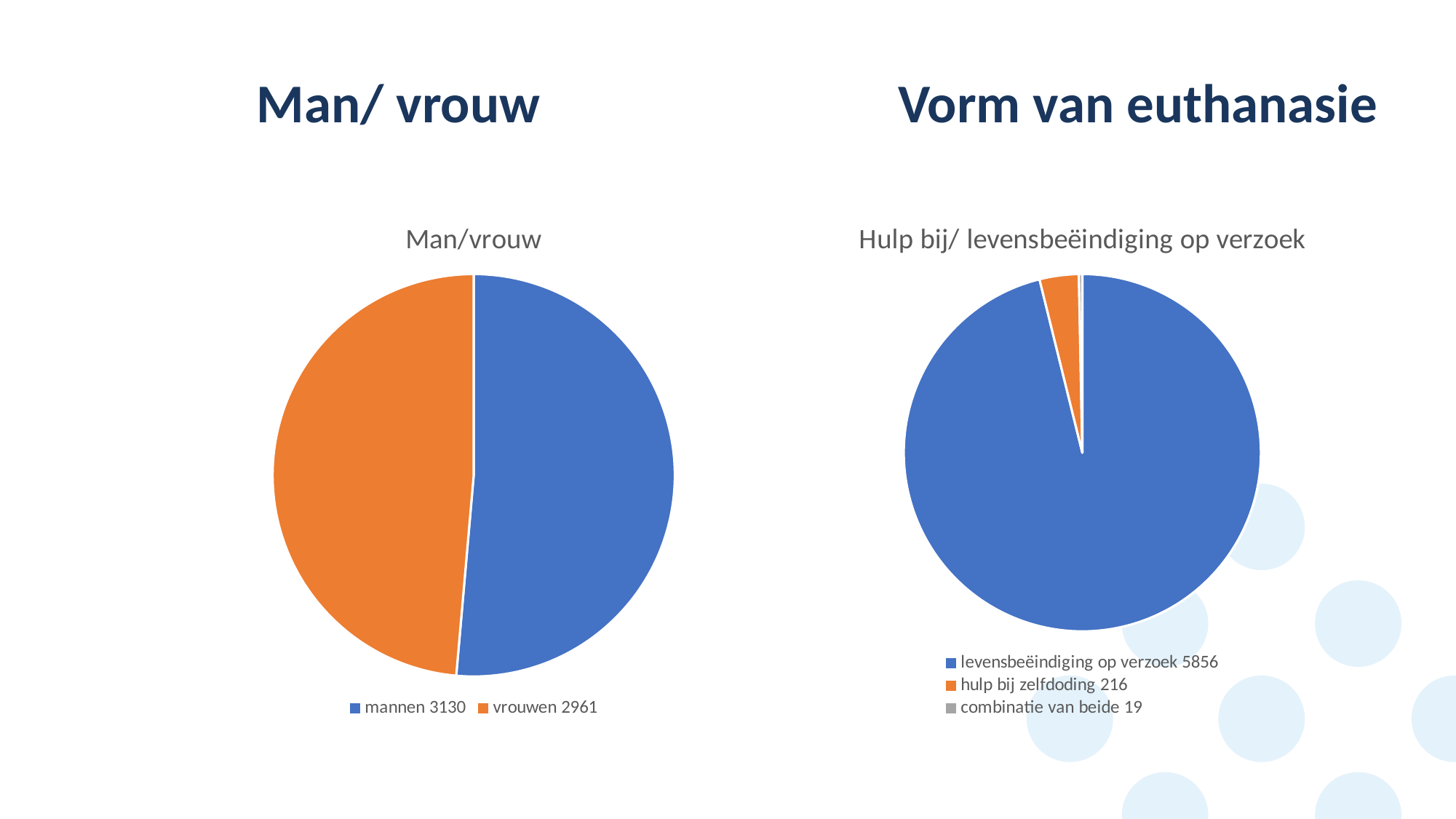
What kind of chart is the Man/vrouw chart? pie chart In the Man/vrouw chart, what is the total of the two categories? 6091 In the Man/vrouw chart, what is the difference between mannen and vrouwen? 169 In the Hulp bij/ levensbeëindiging op verzoek chart, which category is the smallest? combinatie van beide In the Man/vrouw chart, what is the value for vrouwen? 2961 In the Hulp bij/ levensbeëindiging op verzoek chart, what is the value for combinatie van beide? 19 In the Hulp bij/ levensbeëindiging op verzoek chart, how many categories does the legend list? 3 In the Hulp bij/ levensbeëindiging op verzoek chart, which category is the largest? levensbeëindiging op verzoek In the Hulp bij/ levensbeëindiging op verzoek chart, what is the difference between levensbeëindiging op verzoek and hulp bij zelfdoding? 5640 In the Man/vrouw chart, which category is larger, mannen or vrouwen? mannen In the Hulp bij/ levensbeëindiging op verzoek chart, what is the value for hulp bij zelfdoding? 216 In the Man/vrouw chart, what is the value for mannen? 3130